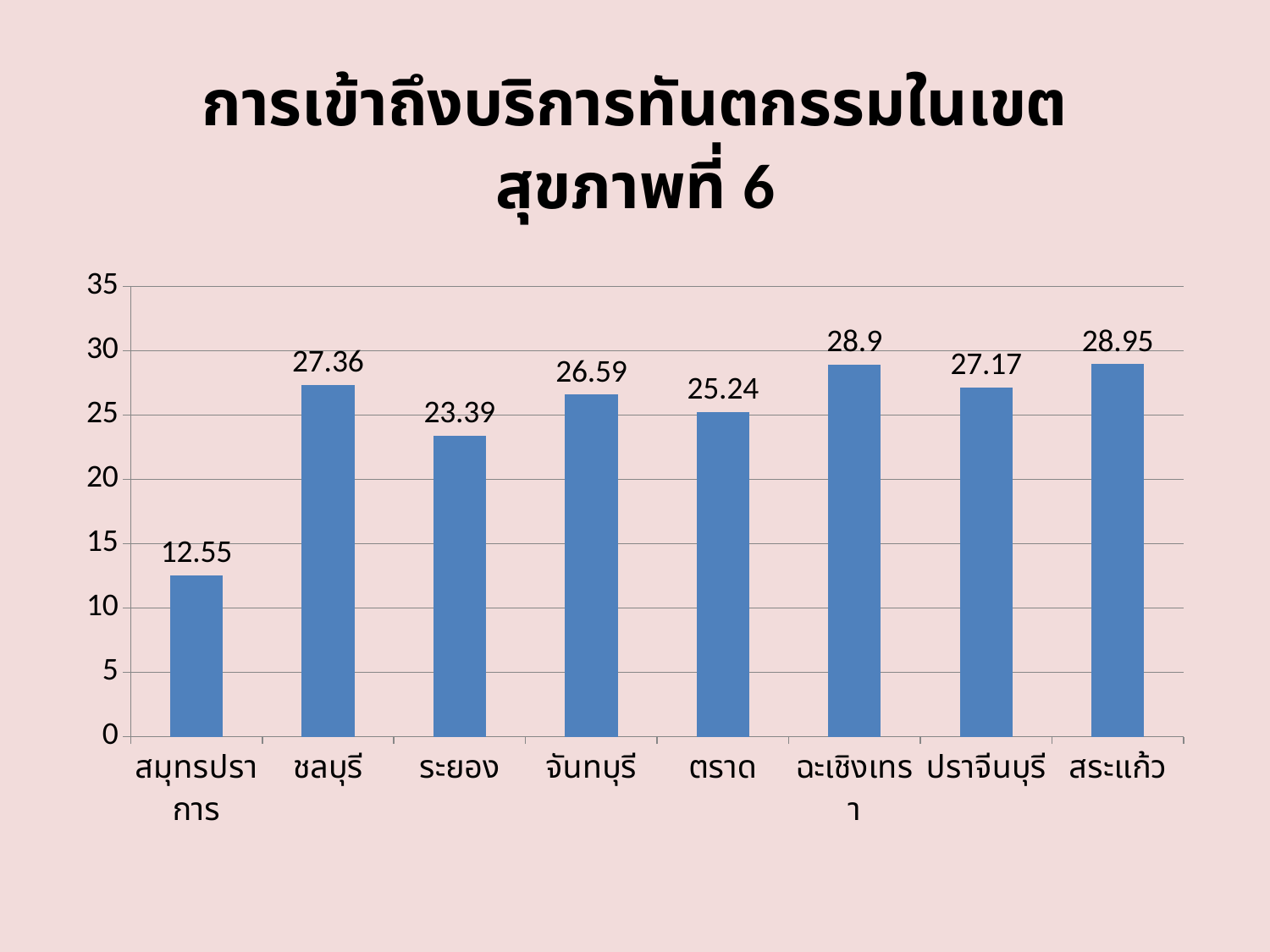
Which province has the lowest value? สมุทรปราการ What kind of chart is shown on the slide? bar chart What is the value for สมุทรปราการ? 12.55 What is the value for ชลบุรี? 27.36 Which is larger, the value for จันทบุรี or the value for ระยอง? จันทบุรี What is the difference between the values for ชลบุรี and ระยอง? 3.97 What is the value for ตราด? 25.24 What is the difference between the values for สระแก้ว and สมุทรปราการ? 16.4 Which province has the highest value? สระแก้ว What is the title of the chart? การเข้าถึงบริการทันตกรรมในเขตสุขภาพที่ 6 What is the value for ฉะเชิงเทรา? 28.9 How many provinces are shown on the chart? 8